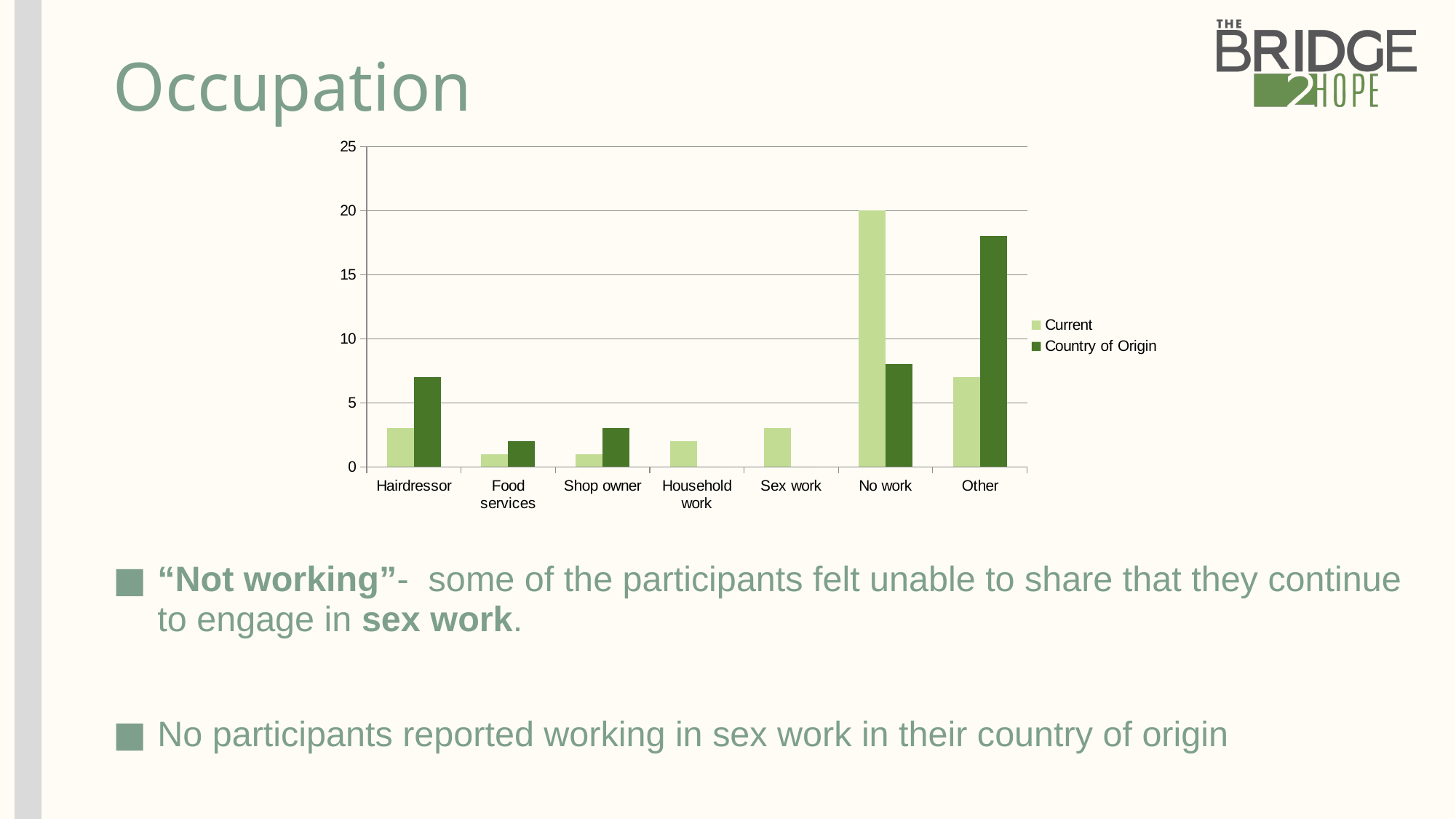
How many occupation categories are shown on the x axis of the chart? 7 Is the Country of Origin value for No work greater or less than 5? greater For No work, which series is larger, Current or Country of Origin? Current Which category has the highest Country of Origin value? Other How many series does the chart's legend list? 2 For Other, which series is larger, Current or Country of Origin? Country of Origin What kind of chart is shown on the slide? bar chart Is the Country of Origin value for Other greater or less than 15? greater What is the Current value for No work? 20 Which category has the highest Current value? No work Is the Current value for Sex work greater or less than 5? less What are the two series named in the chart's legend? Current and Country of Origin